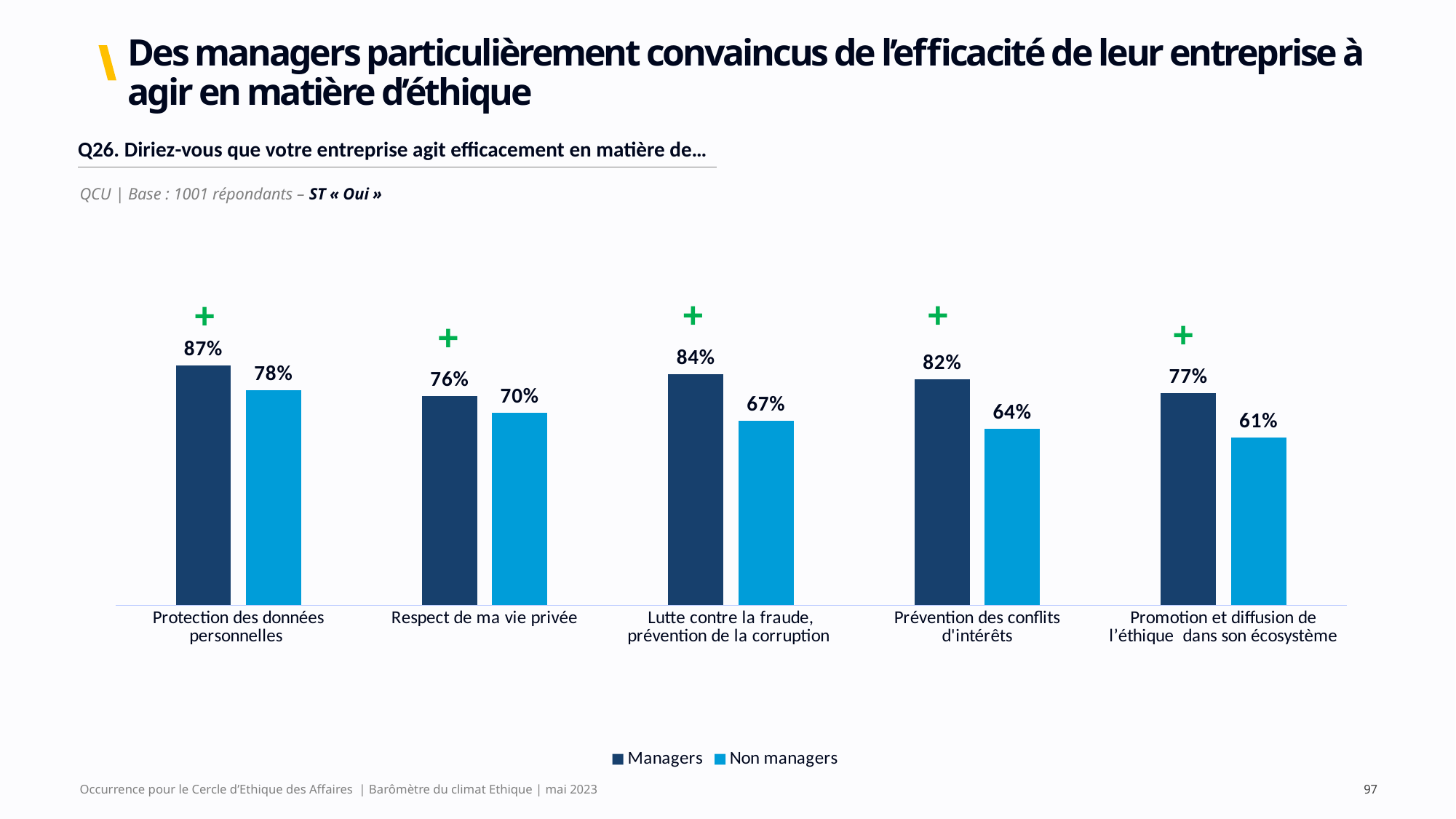
What is the value for Non managers for "Promotion et diffusion de l'éthique dans son écosystème"? 61% Which category has the lowest value for Non managers? Promotion et diffusion de l'éthique dans son écosystème Do the Non managers values rise or fall from left to right along the x axis? Fall How many series does the legend list? 2 How many categories are shown on the x axis? 5 What is the value for Managers for "Protection des données personnelles"? 87% Which is larger for "Respect de ma vie privée": the Managers value or the Non managers value? Managers What is the difference between Managers and Non managers for "Prévention des conflits d'intérêts"? 18 percentage points Which category has the highest value for Managers? Protection des données personnelles Which series is shown in the darker blue colour? Managers What is the value for Non managers for "Lutte contre la fraude, prévention de la corruption"? 67% What kind of chart is shown on the slide? Bar chart